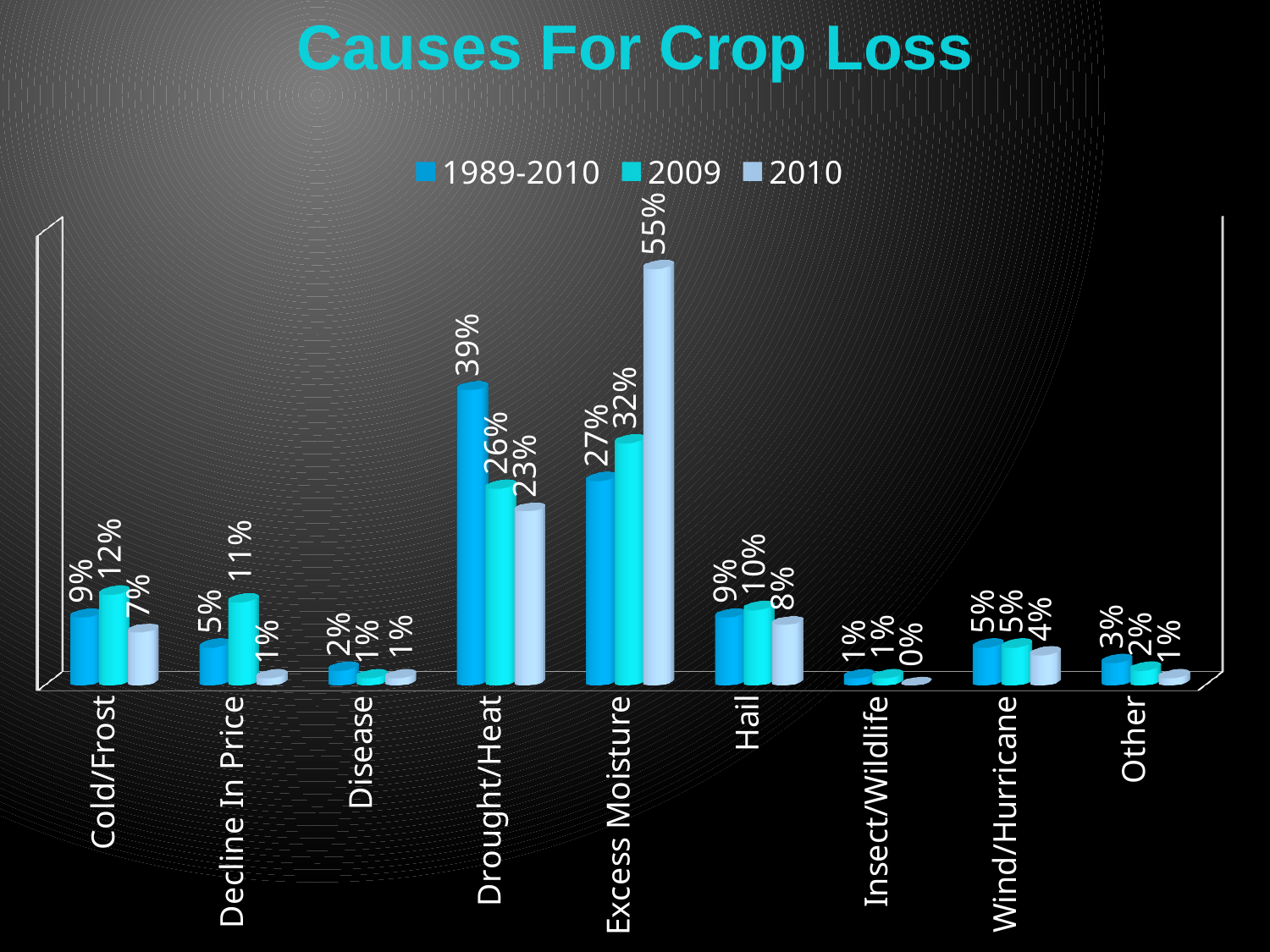
How many cause categories are shown on the x axis? 9 What is the difference between the 2009 and 2010 values for Cold/Frost? 5% What is the 1989-2010 value for Drought/Heat? 39% Which is larger for Drought/Heat: the 1989-2010 value or the 2009 value? 1989-2010 What type of chart is shown on the slide? bar chart How many series does the legend list? 3 Which category has the highest 2010 value? Excess Moisture Which category has the lowest 2010 value? Insect/Wildlife What is the 2010 value for Excess Moisture? 55% What is the difference between the 2010 and 2009 values for Excess Moisture? 23% What is the 2009 value for Decline In Price? 11% What is the title of the chart? Causes For Crop Loss